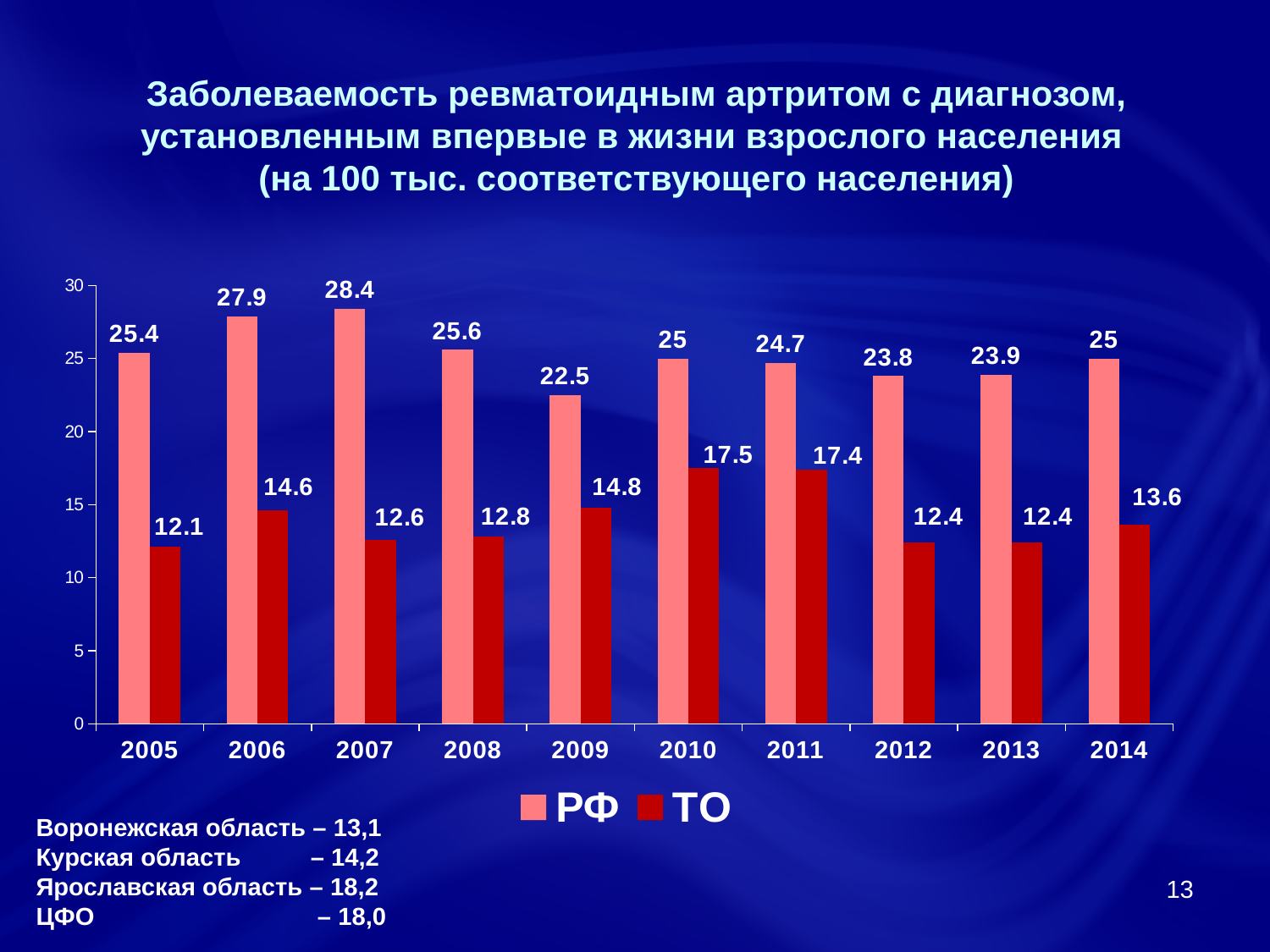
In which year is the РФ value lowest? 2009 What is the value for ТО in 2010? 17.5 In which year is the ТО value highest? 2010 What is the value for РФ in 2007? 28.4 How many years are shown on the x axis? 10 Which series is shown in dark red in the legend? ТО What is the difference between the РФ and ТО values in 2014? 11.4 What is the value for ТО in 2005? 12.1 In which year is the РФ value highest? 2007 How many series does the legend list? 2 Which is larger, the ТО value in 2011 or the ТО value in 2012? 2011 What kind of chart is shown on the slide? bar chart